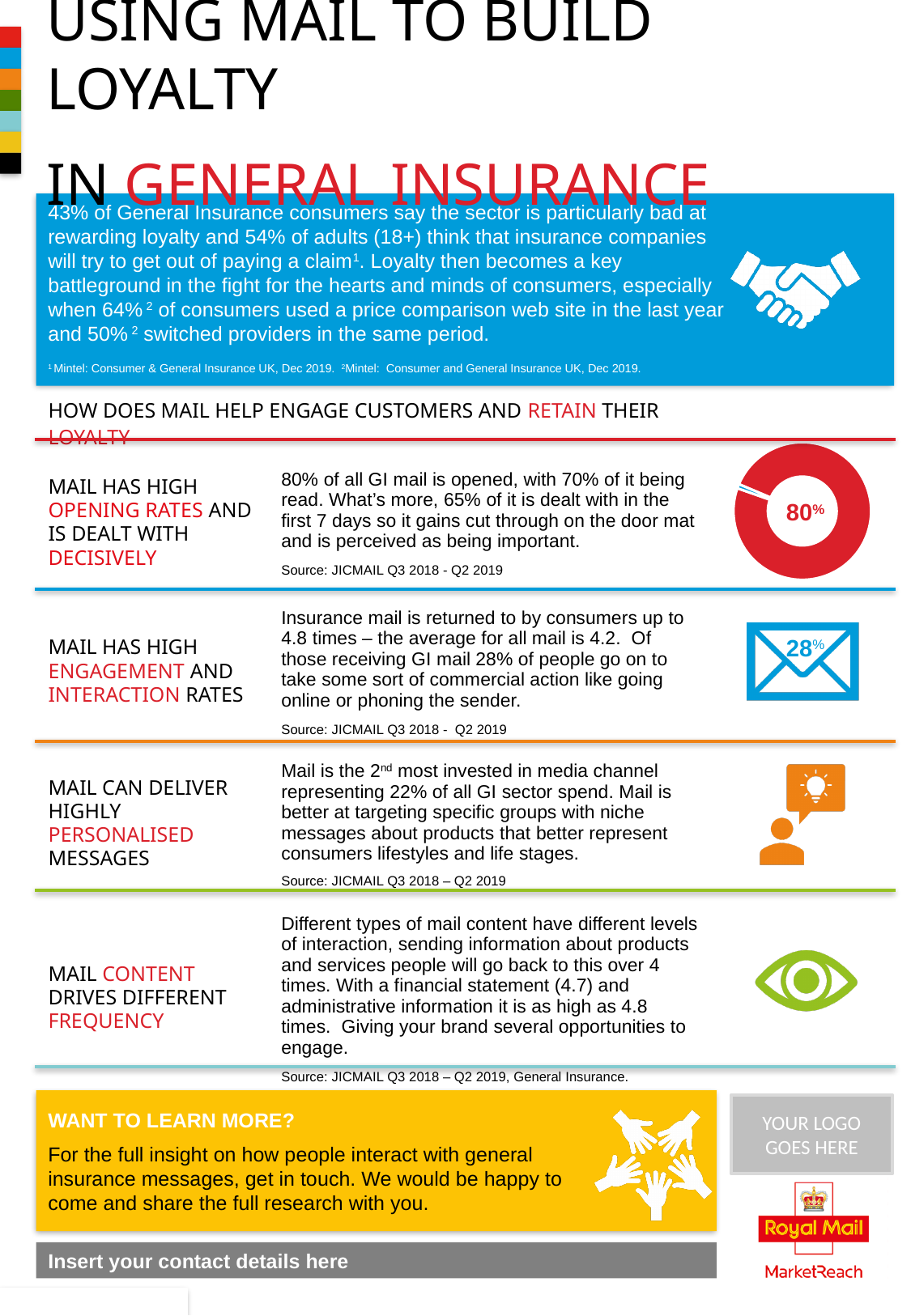
According to the text beside the doughnut chart, what does the 80% figure represent? the share of all GI mail that is opened What colour is the largest segment of the doughnut chart? red What value is printed in the centre of the doughnut chart? 80% In the doughnut chart, which segment is larger, the red one or the white one? red Is the red segment of the doughnut chart greater or less than 50% of the whole? greater What kind of chart is shown next to the 'Mail has high opening rates' row? pie chart (doughnut)